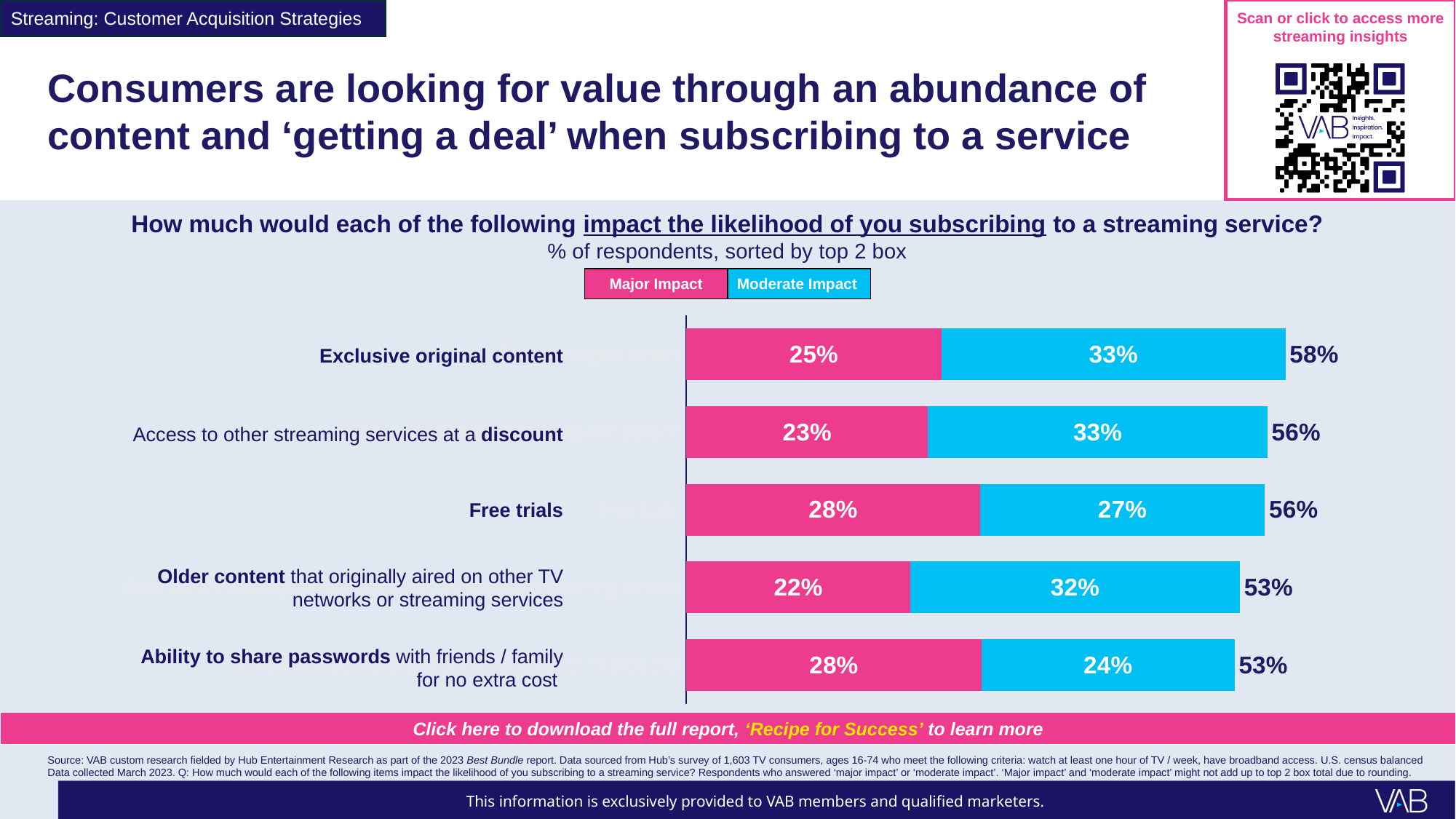
How many series does the legend list? 2 Which category has the lowest Moderate Impact value? Ability to share passwords with friends / family for no extra cost What is the difference between the Moderate Impact values for Exclusive original content and Free trials? 6% What is the top 2 box total shown for Exclusive original content? 58% Which category has the highest top 2 box total? Exclusive original content How many categories are plotted in the chart? 5 Which category has the lowest Major Impact value? Older content that originally aired on other TV networks or streaming services What is the Moderate Impact value for Older content that originally aired on other TV networks or streaming services? 32% Which is larger: the Major Impact value for Free trials or the Major Impact value for Exclusive original content? Free trials What is the Major Impact value for Free trials? 28% What type of chart is shown on the slide? Stacked bar chart What is the Major Impact value for Access to other streaming services at a discount? 23%